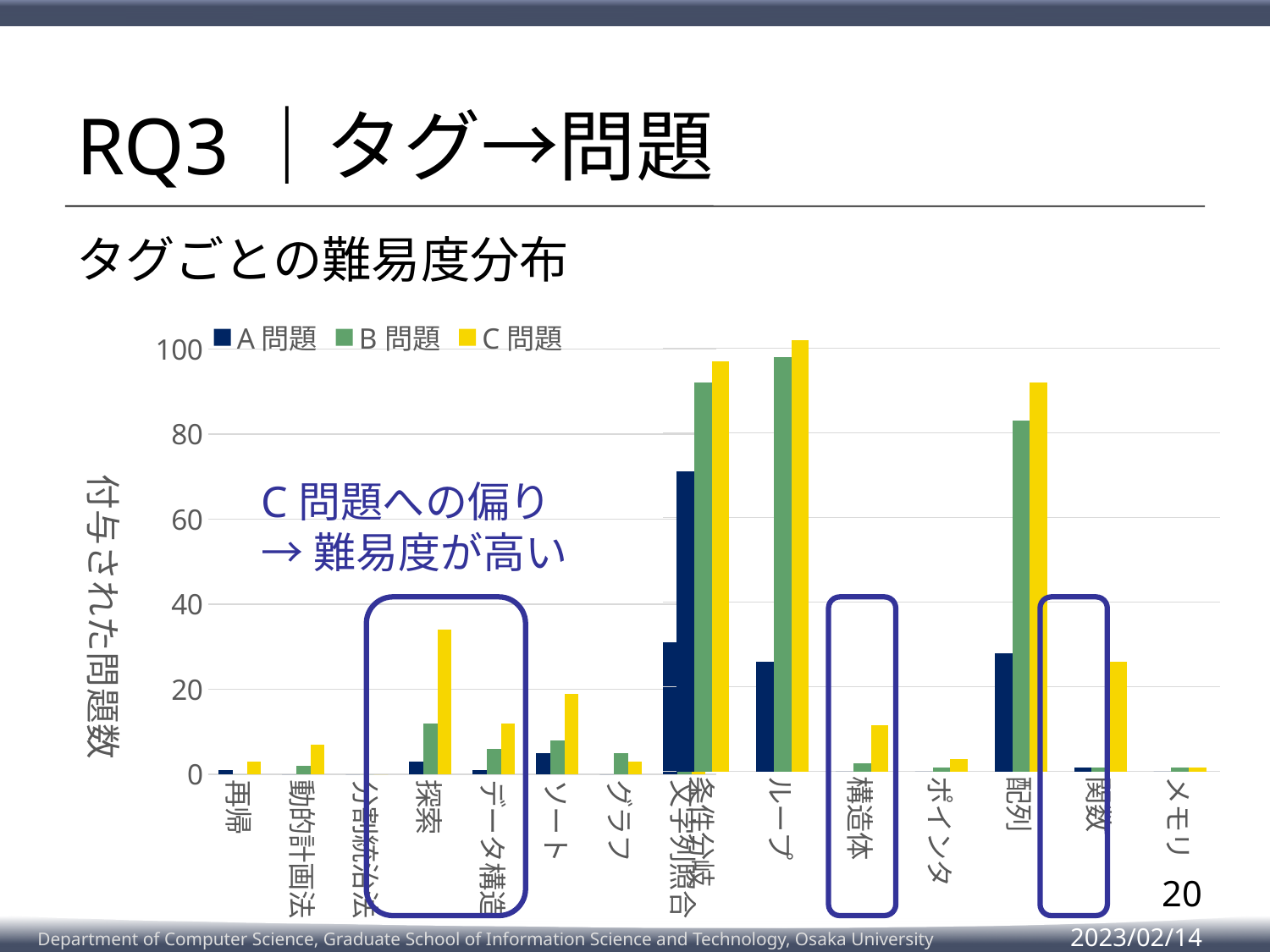
Is the C 問題 value for 探索 greater or less than 20? greater Is the A 問題 value for 配列 greater or less than 40? less Is the B 問題 value for ループ greater or less than 80? greater For 関数, which series has the highest value? C 問題 For ループ, which series has the larger value, A 問題 or B 問題? B 問題 For 探索, which series has the larger value, B 問題 or C 問題? C 問題 How many series does the legend list? 3 What is the label of the vertical axis? 付与された問題数 What are the three series listed in the legend? A 問題, B 問題, C 問題 What kind of chart is shown on the slide? bar chart